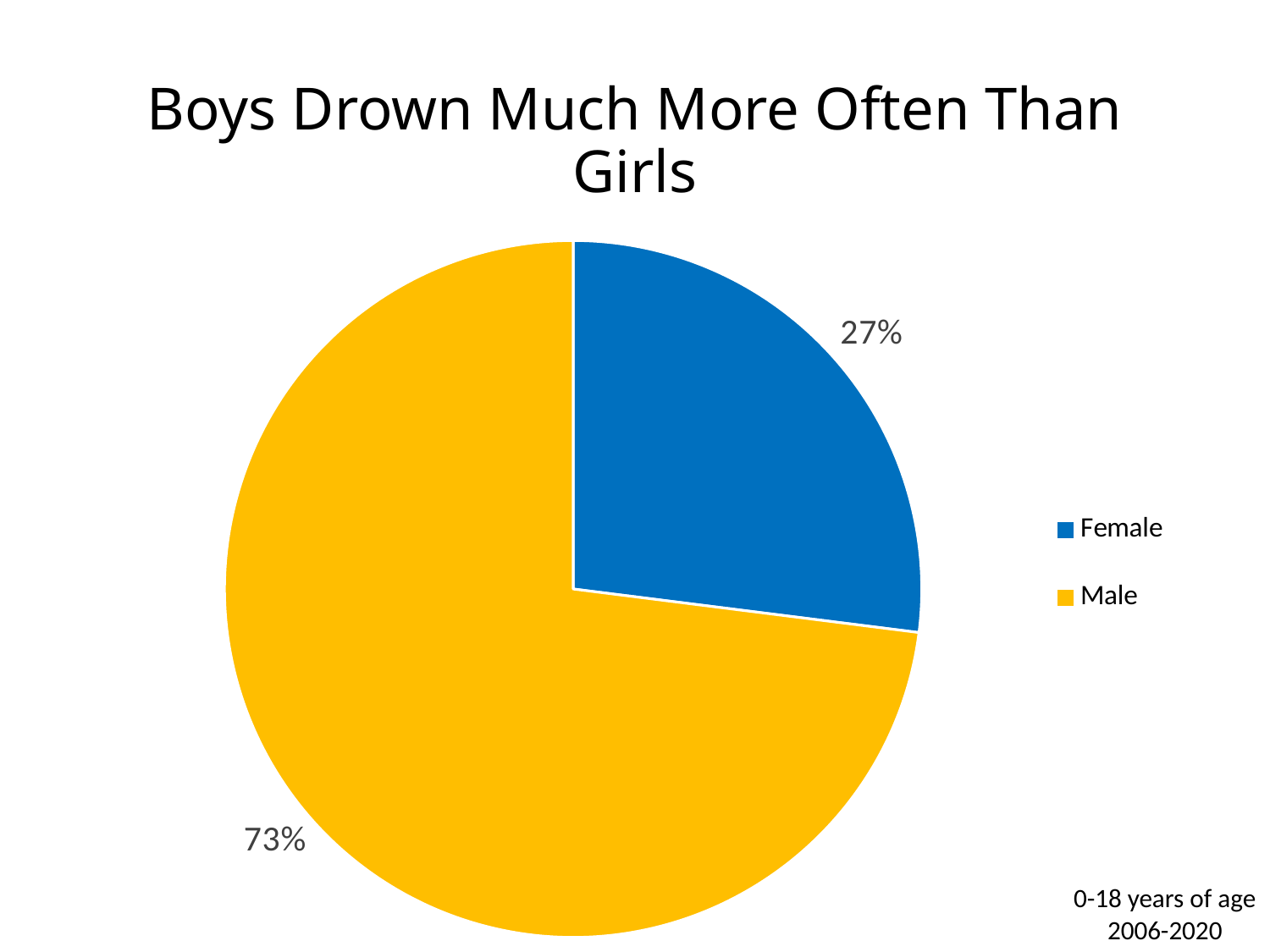
Which category has the smallest share of the pie? Female What kind of chart is shown on the slide? Pie chart How many entries does the legend list? 2 What is the difference in percentage points between the Male and Female shares? 46 Which is larger, the Male share or the Female share? Male What share of the pie does the Female slice represent? 27% What is the title of the slide? Boys Drown Much More Often Than Girls What percentage of the pie is Female? 27% How many slices does the pie chart have? 2 Which category has the largest share of the pie? Male What percentage of the pie is Male? 73% What colour is the Male slice? Yellow